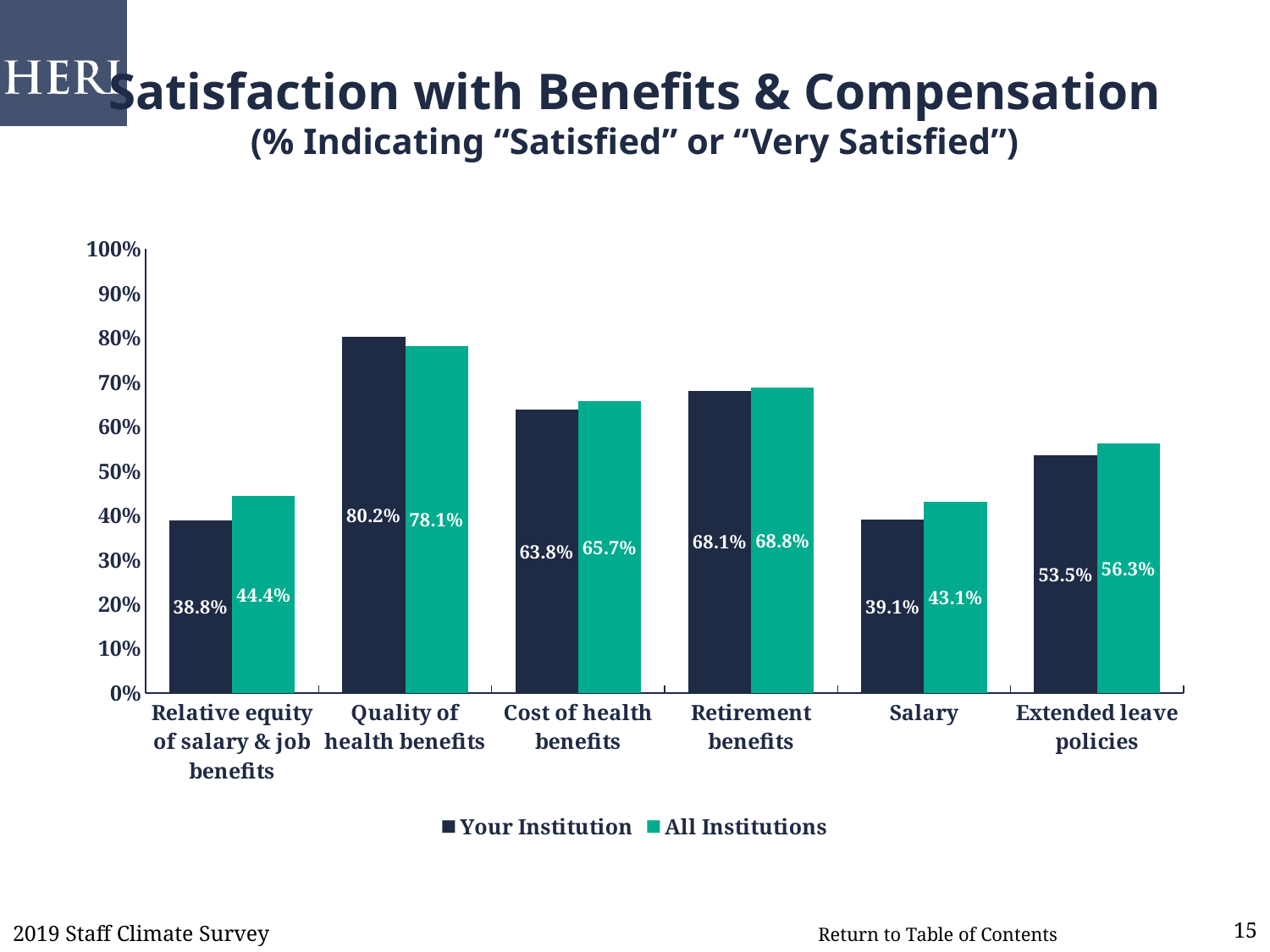
For Salary, which is larger: Your Institution or All Institutions? All Institutions What is the difference between All Institutions and Your Institution for Relative equity of salary & job benefits? 5.6% What is the value for Your Institution for Quality of health benefits? 80.2% How many categories are shown on the x axis? 6 What is the difference between Your Institution and All Institutions for Quality of health benefits? 2.1% Is the value for Your Institution for Retirement benefits greater or less than 60%? greater How many series does the legend list? 2 Which category has the lowest value for Your Institution? Relative equity of salary & job benefits What kind of chart is shown on the slide? Bar chart What is the value for Your Institution for Extended leave policies? 53.5% Which category has the highest value for All Institutions? Quality of health benefits What is the value for All Institutions for Salary? 43.1%